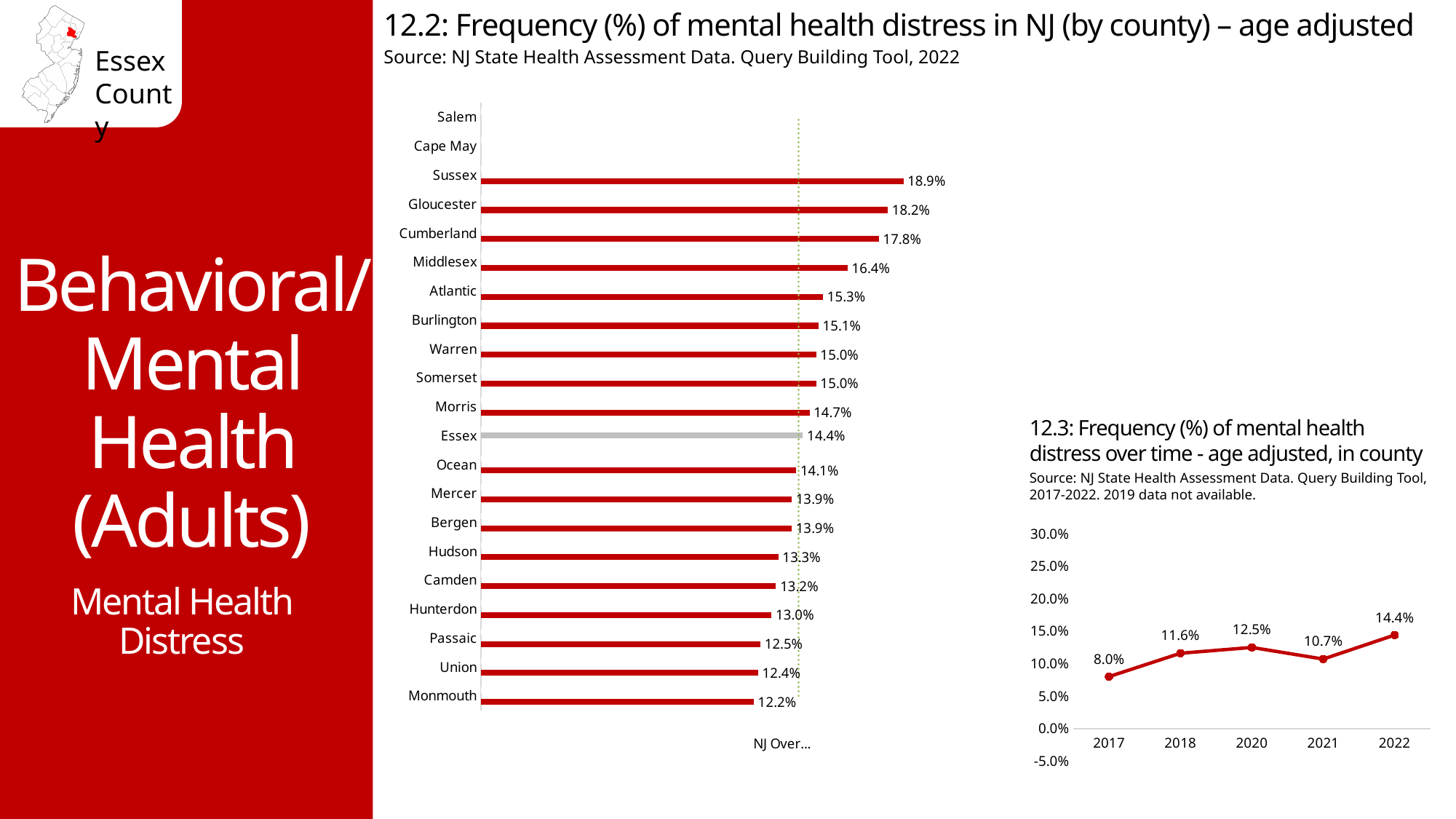
In chart 12.3, what is the value for 2017? 8.0% In chart 12.2, what is the value for Middlesex? 16.4% In chart 12.2, which county has a higher value, Gloucester or Cumberland? Gloucester In chart 12.3, which year has the highest value? 2022 In chart 12.3, what type of chart is used? Line chart In chart 12.3, what is the difference between the 2022 and 2021 values? 3.7% In chart 12.2, which county has the highest frequency of mental health distress? Sussex In chart 12.2, what is the frequency of mental health distress for Essex County? 14.4% In chart 12.2, which county with a plotted bar has the lowest frequency of mental health distress? Monmouth In chart 12.3, how many years are plotted? 5 In chart 12.2, what type of chart is used? Bar chart In chart 12.2, what is the difference between the values for Sussex and Essex? 4.5%